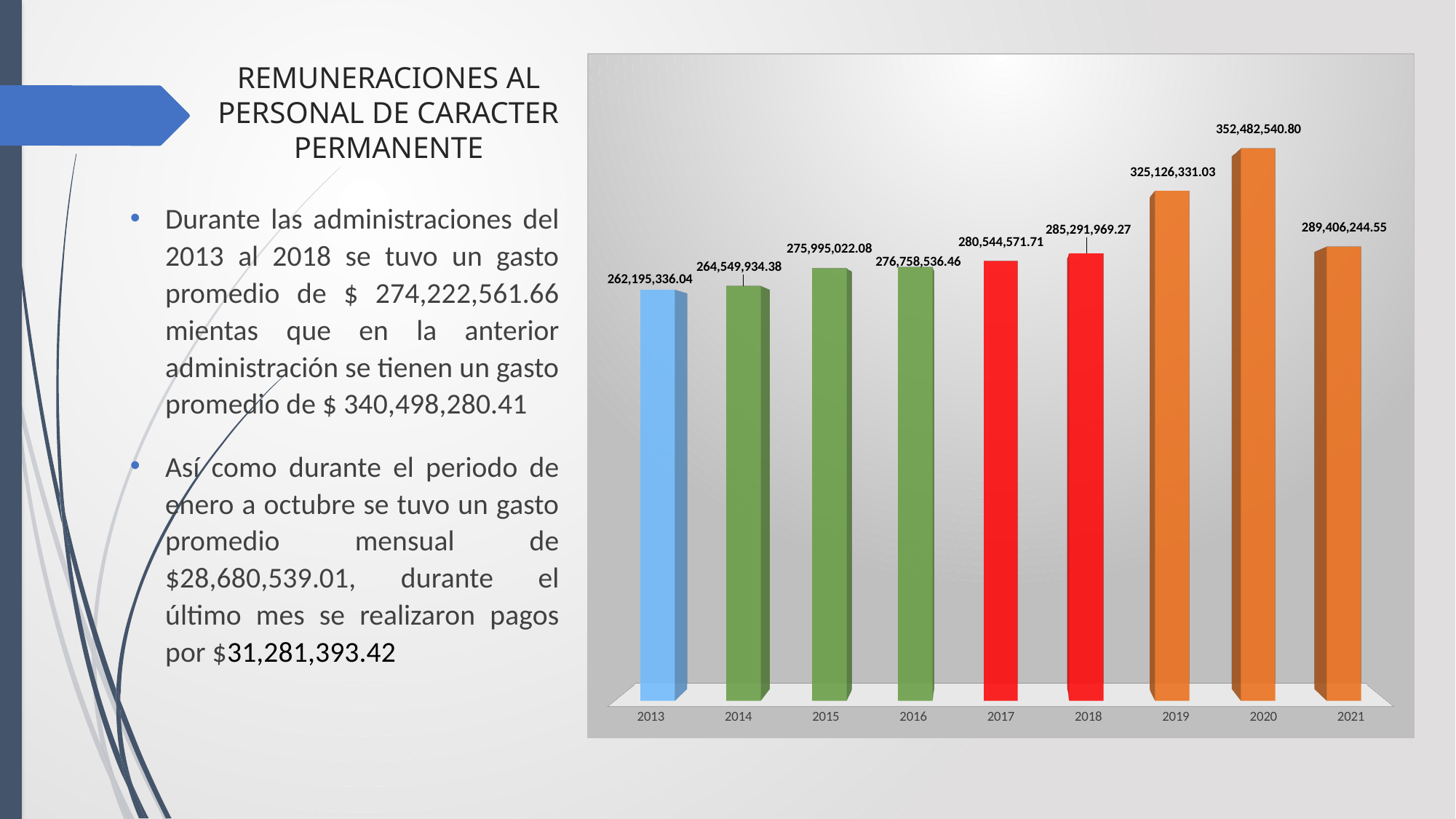
What colour are the bars for 2017 and 2018? Red Do the values rise or fall from 2013 to 2020? Rise What kind of chart is shown? Bar chart What is the value shown for 2021? 289,406,244.55 Which year has the highest value? 2020 What is the difference between the values for 2020 and 2019? 27,356,209.77 What is the value shown for 2018? 285,291,969.27 What is the difference between the values for 2021 and 2013? 27,210,908.51 What is the value shown for 2013? 262,195,336.04 Which year has the lowest value? 2013 Which is larger, the value for 2019 or the value for 2021? 2019 How many years are shown on the x axis? 9